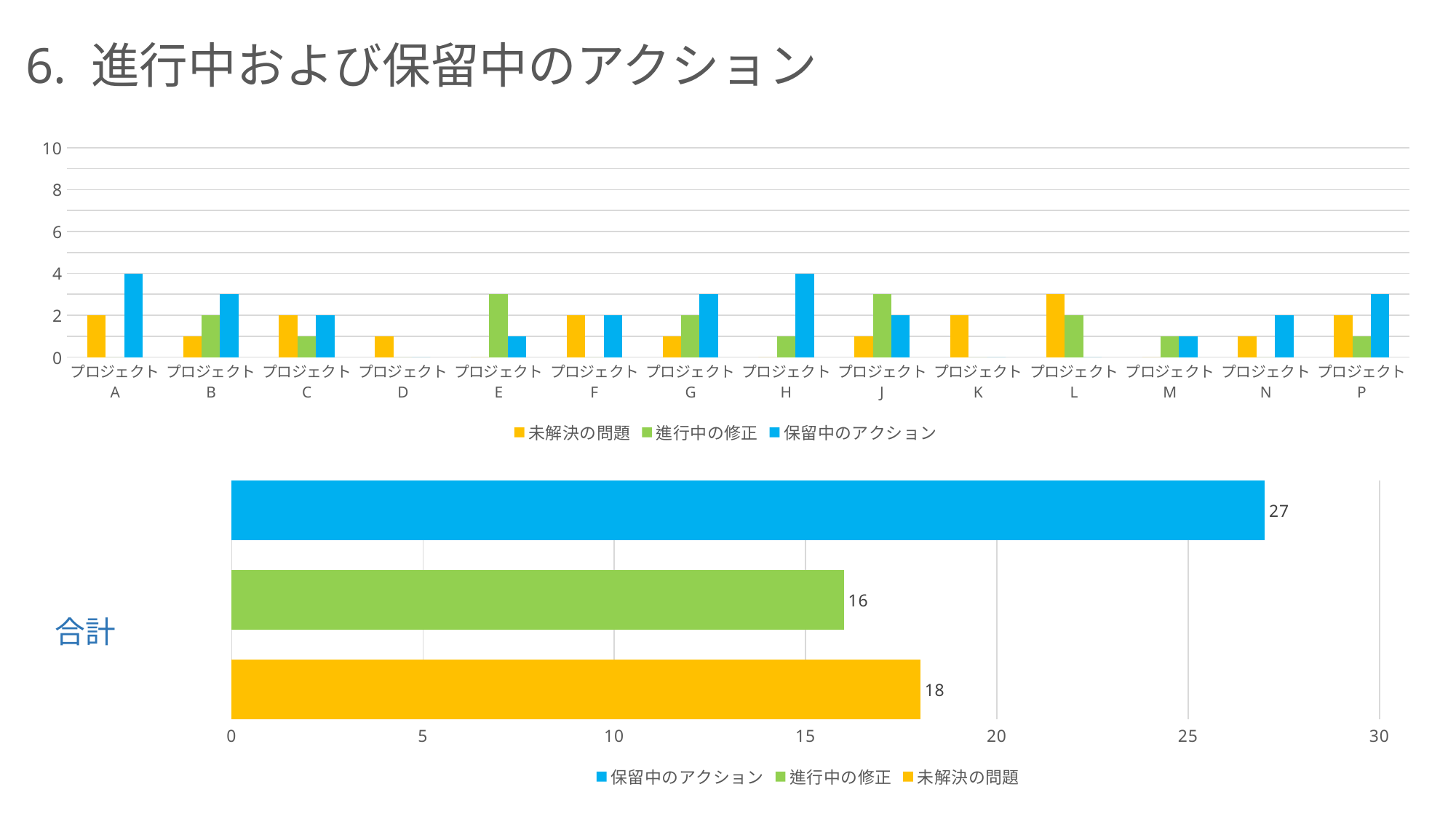
In the top chart, how many series does the legend list? 3 In the bottom chart (合計), which is larger: 未解決の問題 or 進行中の修正? 未解決の問題 In the bottom chart (合計), which category has the lowest value? 進行中の修正 In the bottom chart (合計), what is the value for 未解決の問題? 18 In the bottom chart (合計), what is the value for 進行中の修正? 16 In the bottom chart (合計), what is the value for 保留中のアクション? 27 In the bottom chart (合計), what is the difference between 保留中のアクション and 進行中の修正? 11 In the top chart, what is the value of 保留中のアクション for プロジェクト A? 4 In the top chart, how many projects are shown on the x axis? 14 In the top chart, is the value of 保留中のアクション for プロジェクト H greater or less than 2? greater In the bottom chart (合計), which category has the highest value? 保留中のアクション What kind of chart is the bottom chart (合計)? bar chart